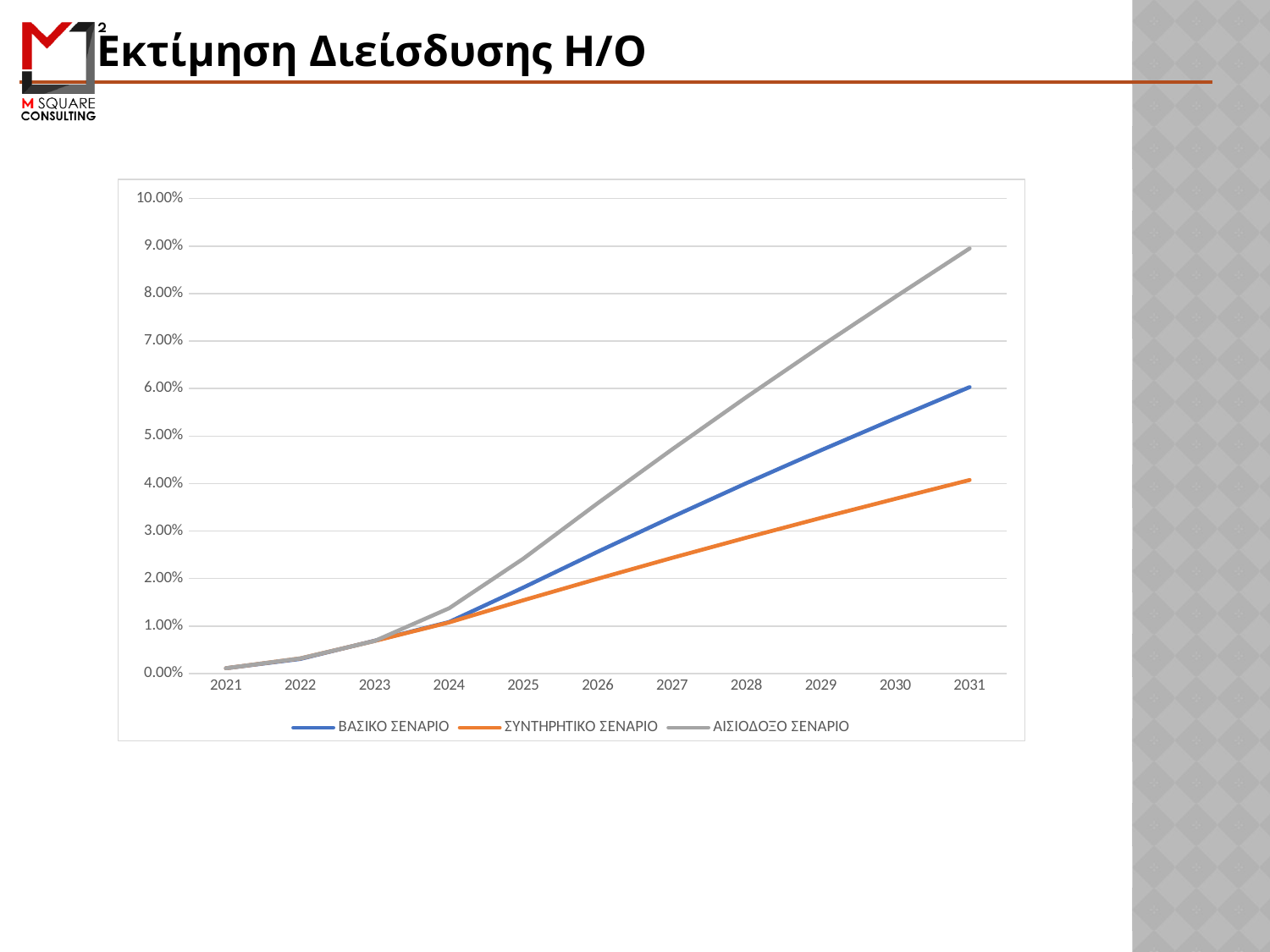
Do the values for ΒΑΣΙΚΟ ΣΕΝΑΡΙΟ rise or fall from 2021 to 2031? rise What colour is the line for ΣΥΝΤΗΡΗΤΙΚΟ ΣΕΝΑΡΙΟ? orange Which series has the lowest value in 2031? ΣΥΝΤΗΡΗΤΙΚΟ ΣΕΝΑΡΙΟ Is the value for ΒΑΣΙΚΟ ΣΕΝΑΡΙΟ in 2031 greater or less than 5.00%? greater Is the value for ΑΙΣΙΟΔΟΞΟ ΣΕΝΑΡΙΟ in 2031 greater or less than 8.00%? greater In 2028, which is larger: ΒΑΣΙΚΟ ΣΕΝΑΡΙΟ or ΣΥΝΤΗΡΗΤΙΚΟ ΣΕΝΑΡΙΟ? ΒΑΣΙΚΟ ΣΕΝΑΡΙΟ How many years are shown on the x axis? 11 What type of chart is shown on the slide? line chart Which series has the highest value in 2031? ΑΙΣΙΟΔΟΞΟ ΣΕΝΑΡΙΟ How many series does the legend list? 3 Is the value for ΑΙΣΙΟΔΟΞΟ ΣΕΝΑΡΙΟ in 2024 greater or less than 2.00%? less